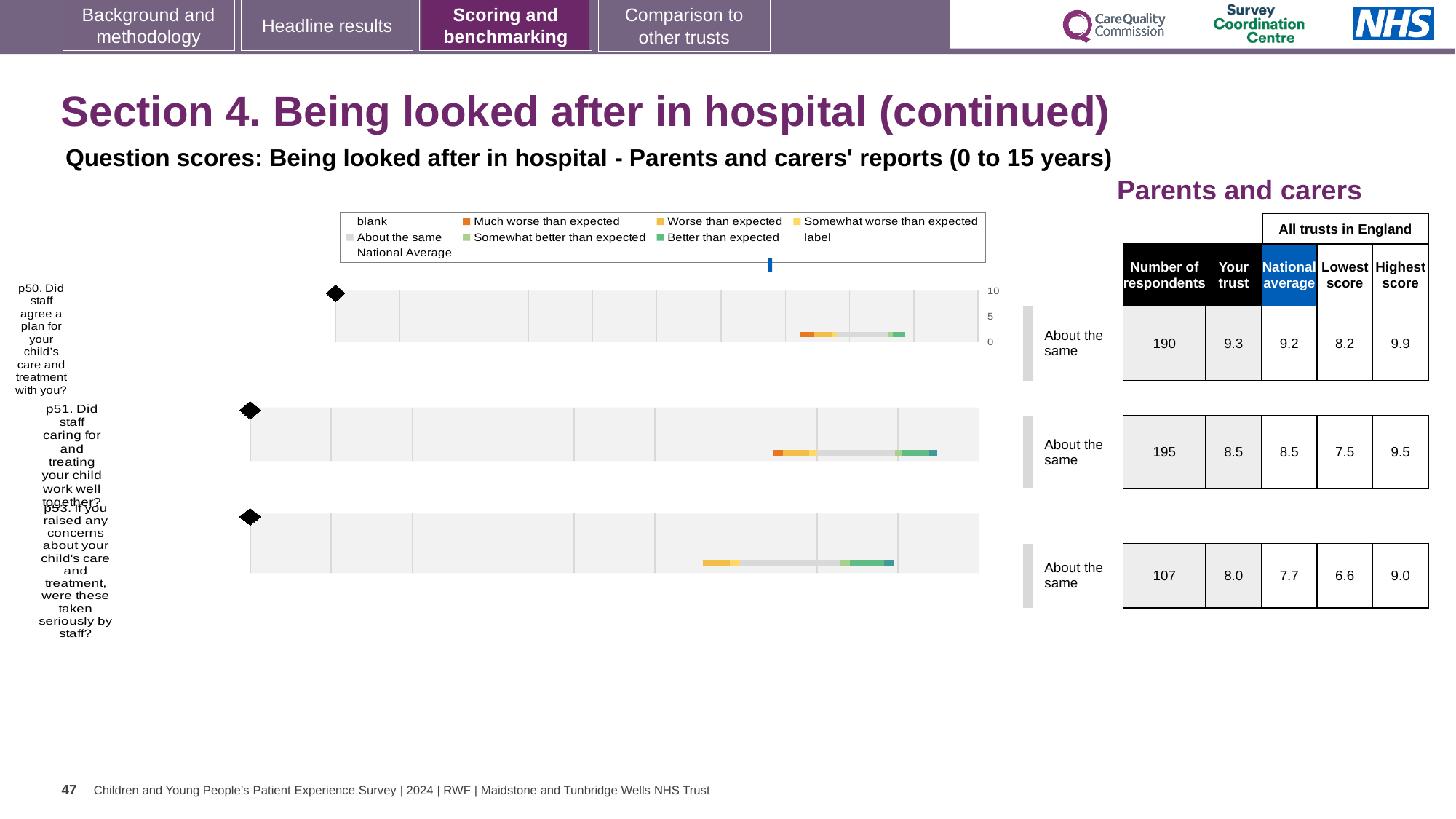
For p53 (If you raised any concerns about your child's care and treatment, were these taken seriously by staff?), how many respondents were there? 107 For p50, what is the difference between the highest score (9.9) and the lowest score (8.2) among all trusts in England? 1.7 For p51 (Did staff caring for and treating your child work well together?), what is the national average score? 8.5 For p53, what is the lowest score among all trusts in England? 6.6 How many entries does the chart legend list? 9 For p53, is the 'Your trust' score higher or lower than the national average? higher Which question has the lowest 'Your trust' score? p53 For p50 (Did staff agree a plan for your child's care and treatment with you?), what is the 'Your trust' score? 9.3 Which question has the highest number of respondents? p51 How many questions (p50, p51, p53) have a chart on this slide? 3 What kind of chart is used to show the question scores on this slide? bar chart What benchmark category is shown next to each of the three charts? About the same